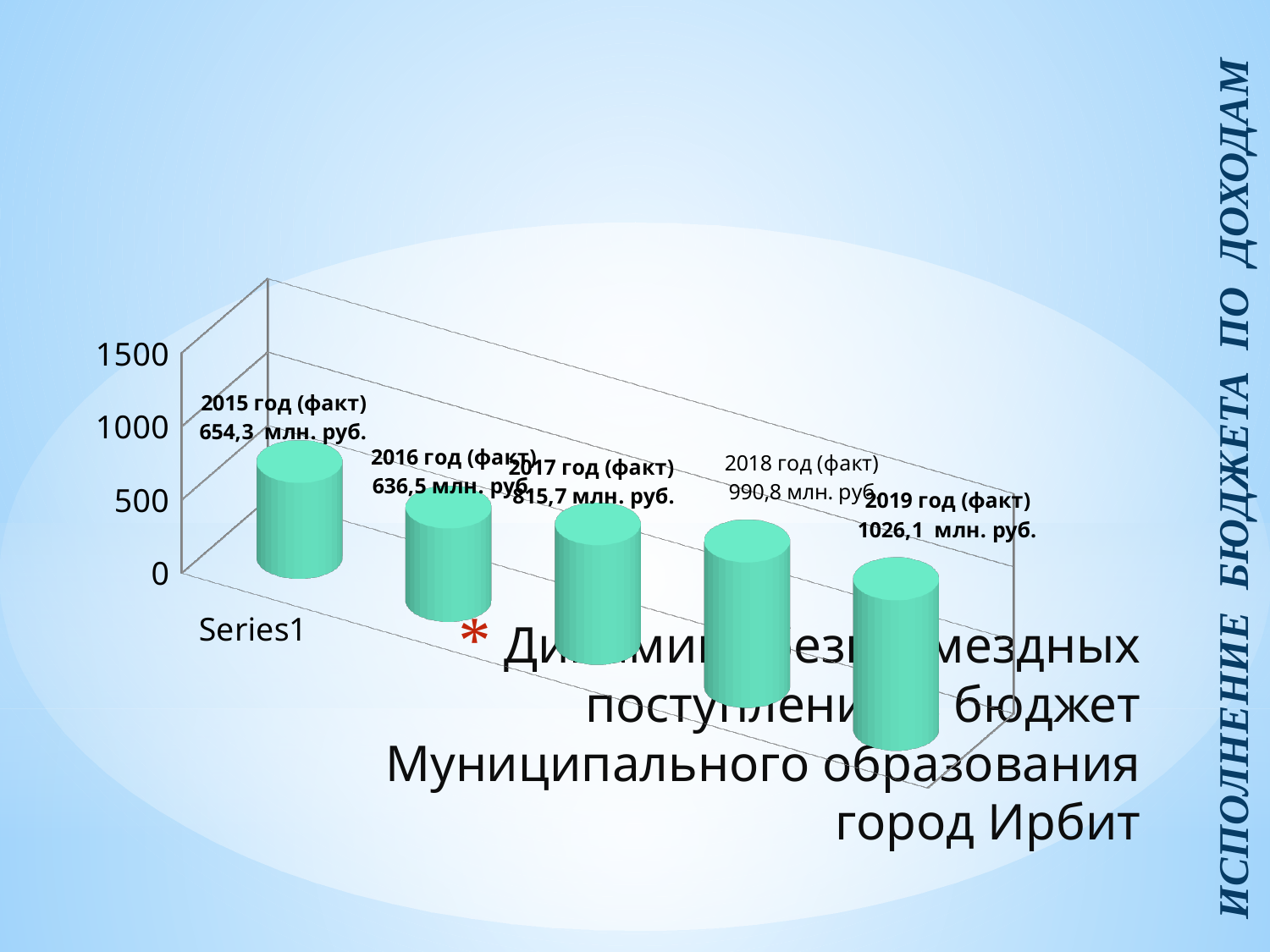
What kind of chart is shown on the slide? bar chart Do the values generally rise or fall from 2016 to 2019? rise What is the difference between the values for 2019 год (факт) and 2018 год (факт)? 35,3 млн. руб. Which year has the lowest value on the chart? 2016 год (факт) What value is shown for 2018 год (факт)? 990,8 млн. руб. How many bars are plotted on the chart? 5 Which is larger: the value for 2015 год (факт) or 2016 год (факт)? 2015 год (факт) What value is shown for 2015 год (факт)? 654,3 млн. руб. Is the value for 2017 год (факт) greater or less than 1000? less Which year has the highest value on the chart? 2019 год (факт) What value is shown for 2019 год (факт)? 1026,1 млн. руб. What value is shown for 2017 год (факт)? 815,7 млн. руб.